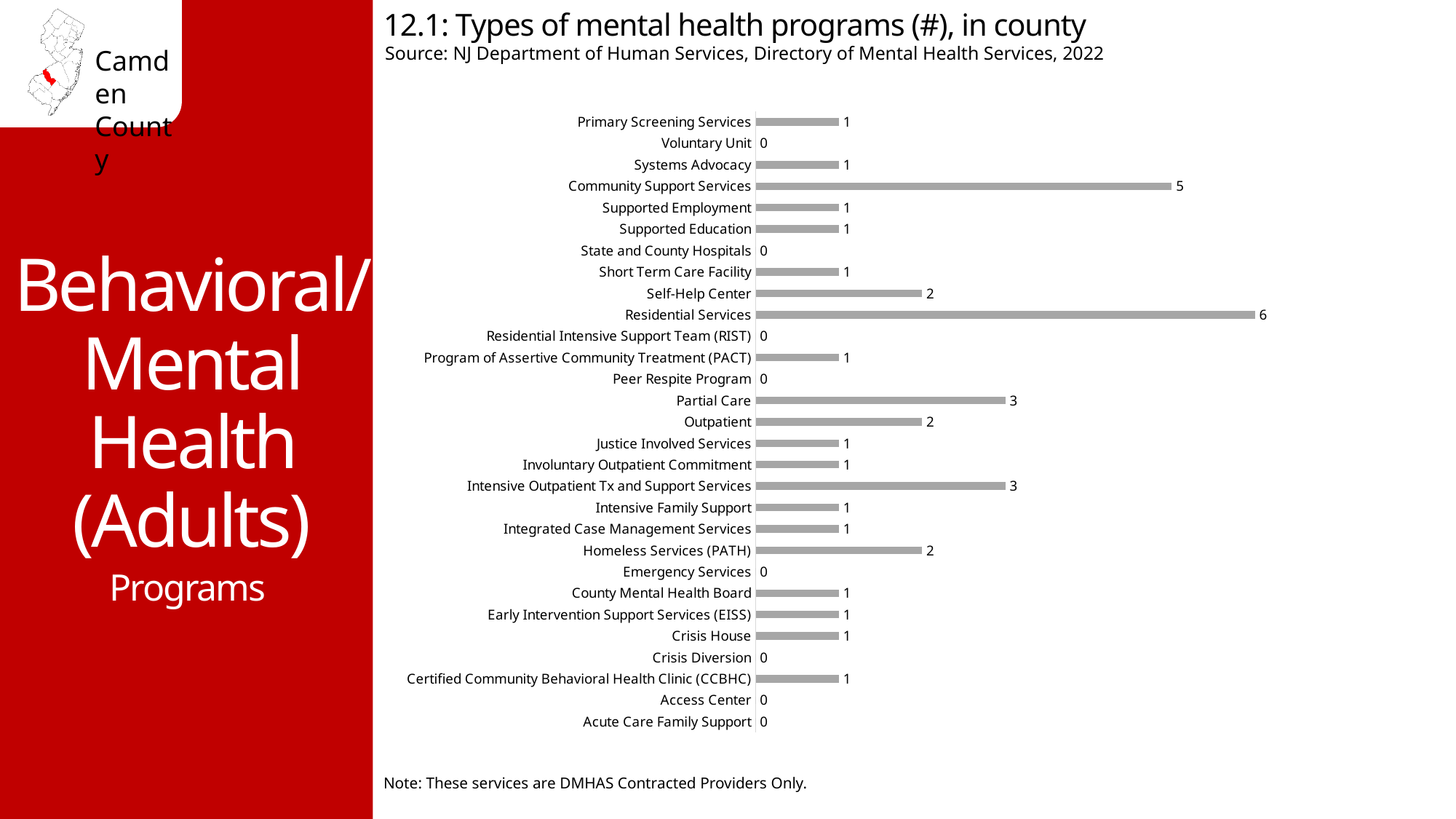
How many categories are shown in the chart? 29 Which is larger, Partial Care or Outpatient? Partial Care What is the value for Community Support Services? 5 What is the difference between Self-Help Center and Short Term Care Facility? 1 How many categories have a value of 0? 8 What is the value for Partial Care? 3 What is the value for Homeless Services (PATH)? 2 What is the difference between Residential Services and Community Support Services? 1 Which category has the highest value? Residential Services What is the title of the chart? 12.1: Types of mental health programs (#), in county What kind of chart is this? Bar chart What is the value for Residential Services? 6